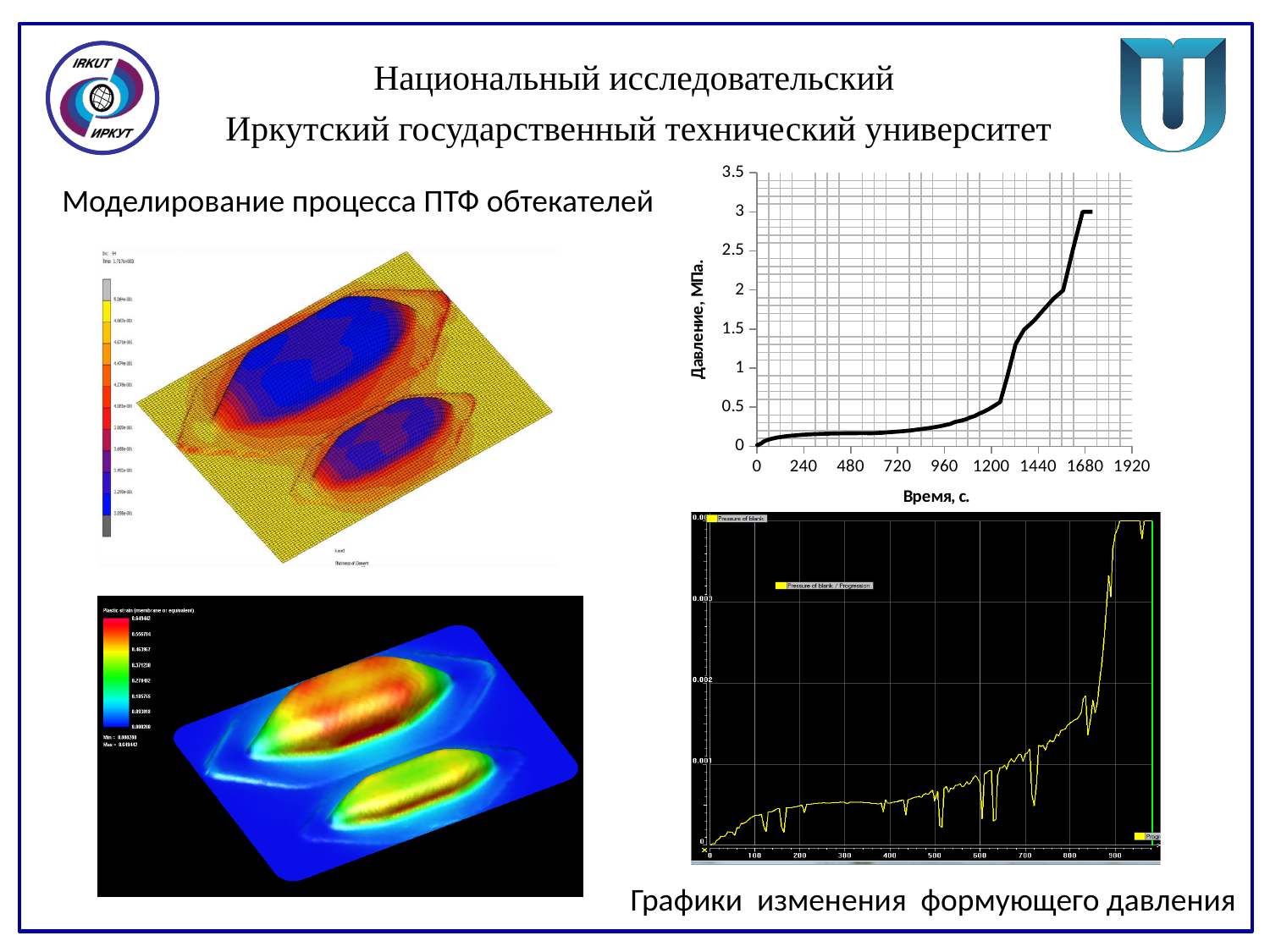
What kind of chart is the bottom right chart (Pressure of blank / Progression)? line chart In the top right chart, do the values rise or fall as time increases along the x axis? rise In the bottom right chart, do the values rise or fall overall as the x axis increases? rise In the top right chart, is the pressure at time 1440 greater or less than 1? greater In the top right chart, is the pressure at time 1200 greater or less than 1? less In the bottom right chart, is the value at x = 400 greater or less than 0.001? less In the top right chart, what is the label of the vertical axis? Давление, МПа. In the top right chart, what is the label of the horizontal axis? Время, с. In the top right chart, is the pressure at time 1440 greater or less than the pressure at time 720? greater What kind of chart is the top chart on the right of the slide (pressure vs time)? line chart